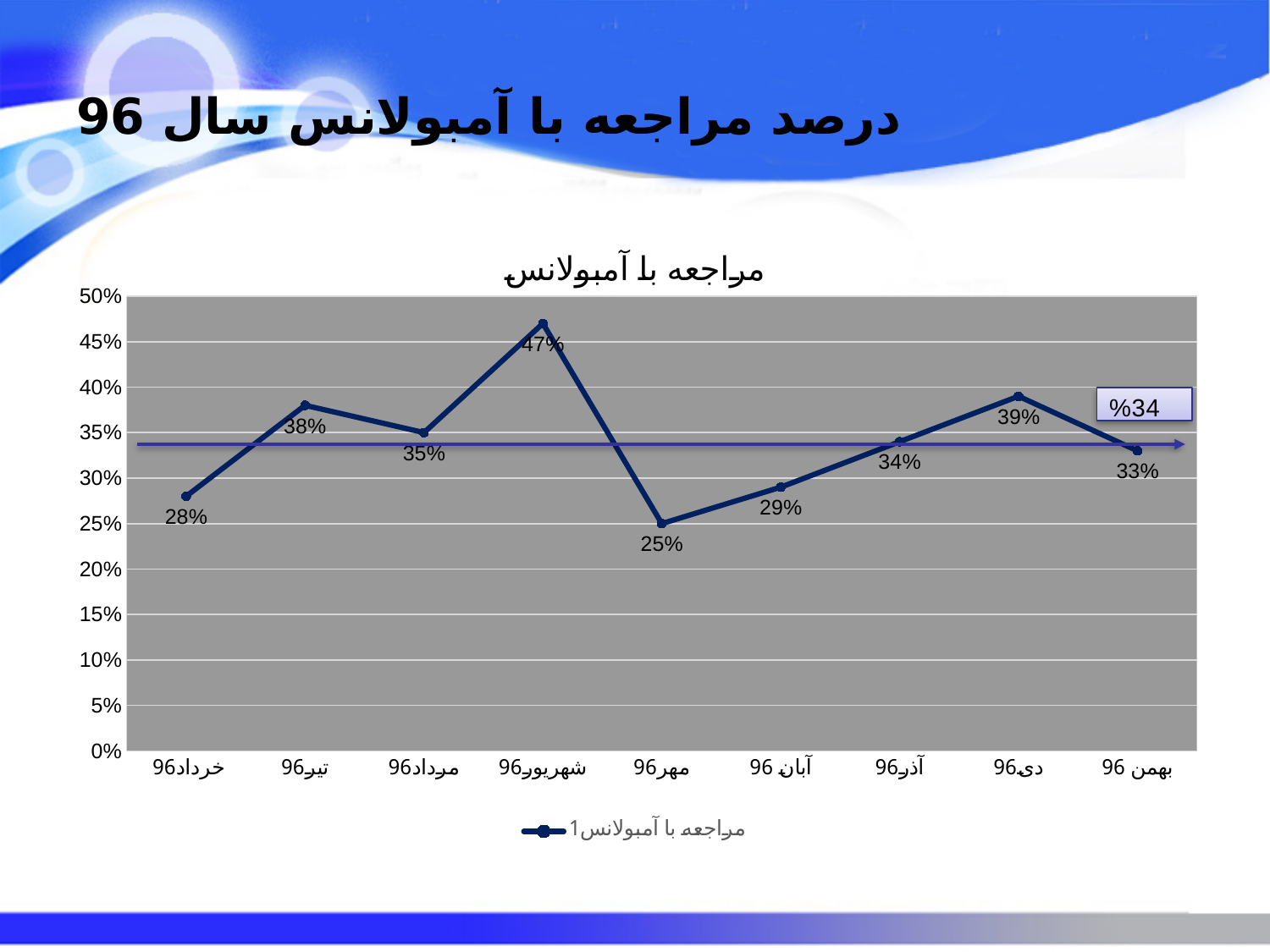
Which is larger, the value for تیر96 or the value for مرداد96? تیر96 What is the value for شهریور96? 47% Which month has the lowest value? مهر96 What is the value for مهر96? 25% What is the value for خرداد96? 28% Which month has the highest value? شهریور96 How many series does the legend list? 1 How many months are plotted on the x axis? 9 What is the value for دی96? 39% What is the difference between the values for شهریور96 and مهر96? 22% What type of chart is shown on the slide? line chart What value is labelled on the horizontal reference line drawn across the chart? %34